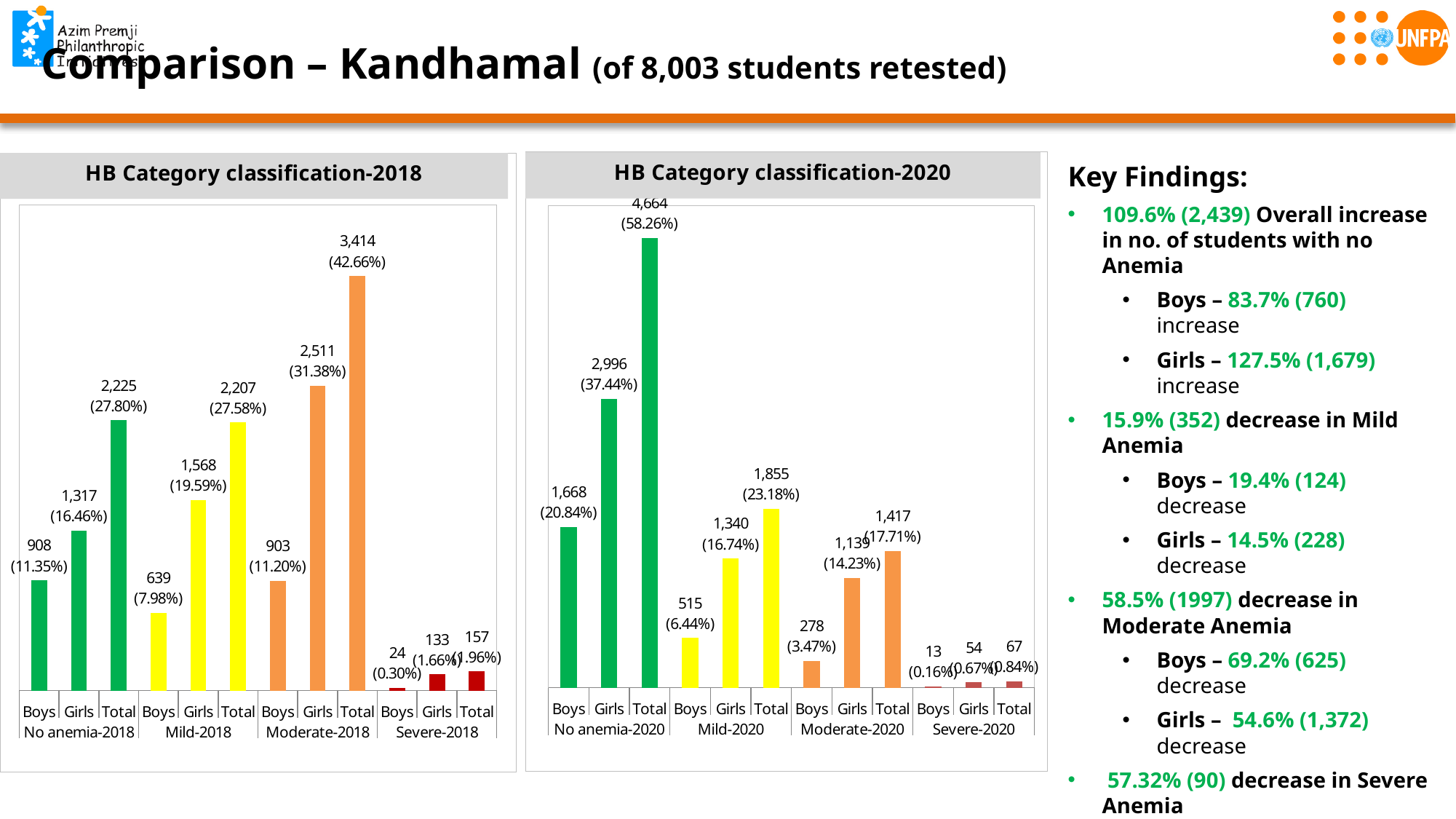
How many anemia category groups are shown on the x axis of the 'HB Category classification-2020' chart? 4 What type of chart is 'HB Category classification-2020'? Bar chart In the 'HB Category classification-2018' chart, which bar is the highest? Total, Moderate-2018 In the 'HB Category classification-2020' chart, what is the value for Girls under Mild-2020? 1,340 (16.74%) How many bars are plotted in the 'HB Category classification-2018' chart? 12 In the 'HB Category classification-2018' chart, which is larger: Girls under Mild-2018 or Girls under Moderate-2018? Girls under Moderate-2018 In the 'HB Category classification-2018' chart, what is the value for Boys under Moderate-2018? 903 (11.20%) In the 'HB Category classification-2020' chart, which bar is the lowest? Boys, Severe-2020 In the 'HB Category classification-2020' chart, what is the difference between Girls and Boys under Moderate-2020? 861 In the 'HB Category classification-2020' chart, what is the difference between the Total for No anemia-2020 and the Total for Mild-2020? 2,809 In the 'HB Category classification-2018' chart, what is the value for Boys under Severe-2018? 24 (0.30%) In the 'HB Category classification-2018' chart, what is the value for Total under No anemia-2018? 2,225 (27.80%)